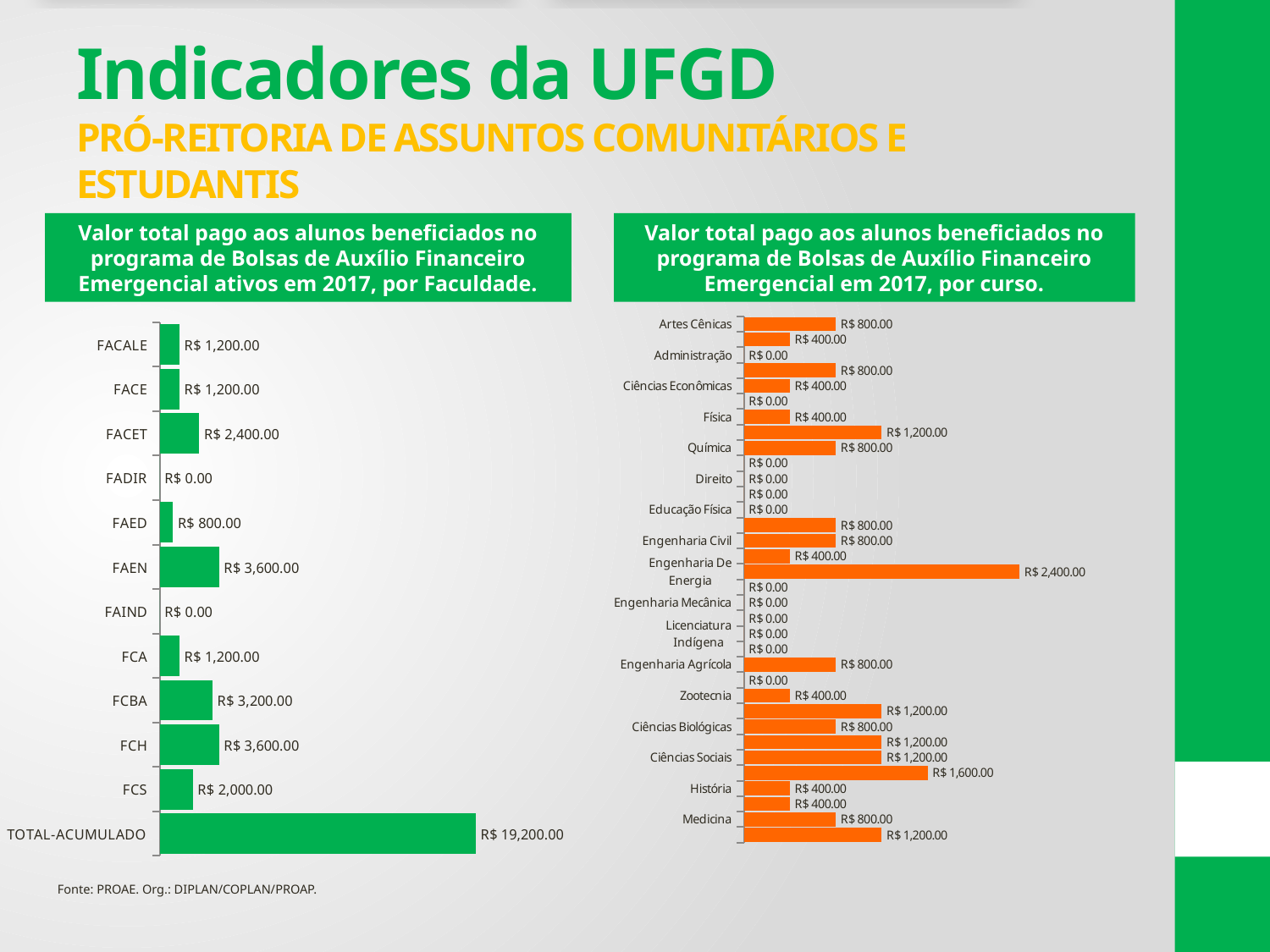
In the left chart (by Faculdade), which category has the highest value? TOTAL-ACUMULADO In the left chart (by Faculdade), what is the value for TOTAL-ACUMULADO? R$ 19,200.00 In the right chart (por curso), what is the largest value shown on any bar? R$ 2,400.00 In the left chart (by Faculdade), which has the larger value, FAEN or FCBA? FAEN In the left chart (by Faculdade), what is the value for FCBA? R$ 3,200.00 In the left chart (by Faculdade), what is the difference between the values for FCH and FCS? R$ 1,600.00 In the left chart (by Faculdade), what is the value for FAED? R$ 800.00 In the left chart (by Faculdade), what is the value for FACET? R$ 2,400.00 In the left chart (by Faculdade), what is the difference between the values for FACET and FACALE? R$ 1,200.00 In the left chart (by Faculdade), how many bars are plotted? 12 What kind of chart is the left chart (by Faculdade)? Bar chart What colour are the bars in the right chart (por curso)? Orange